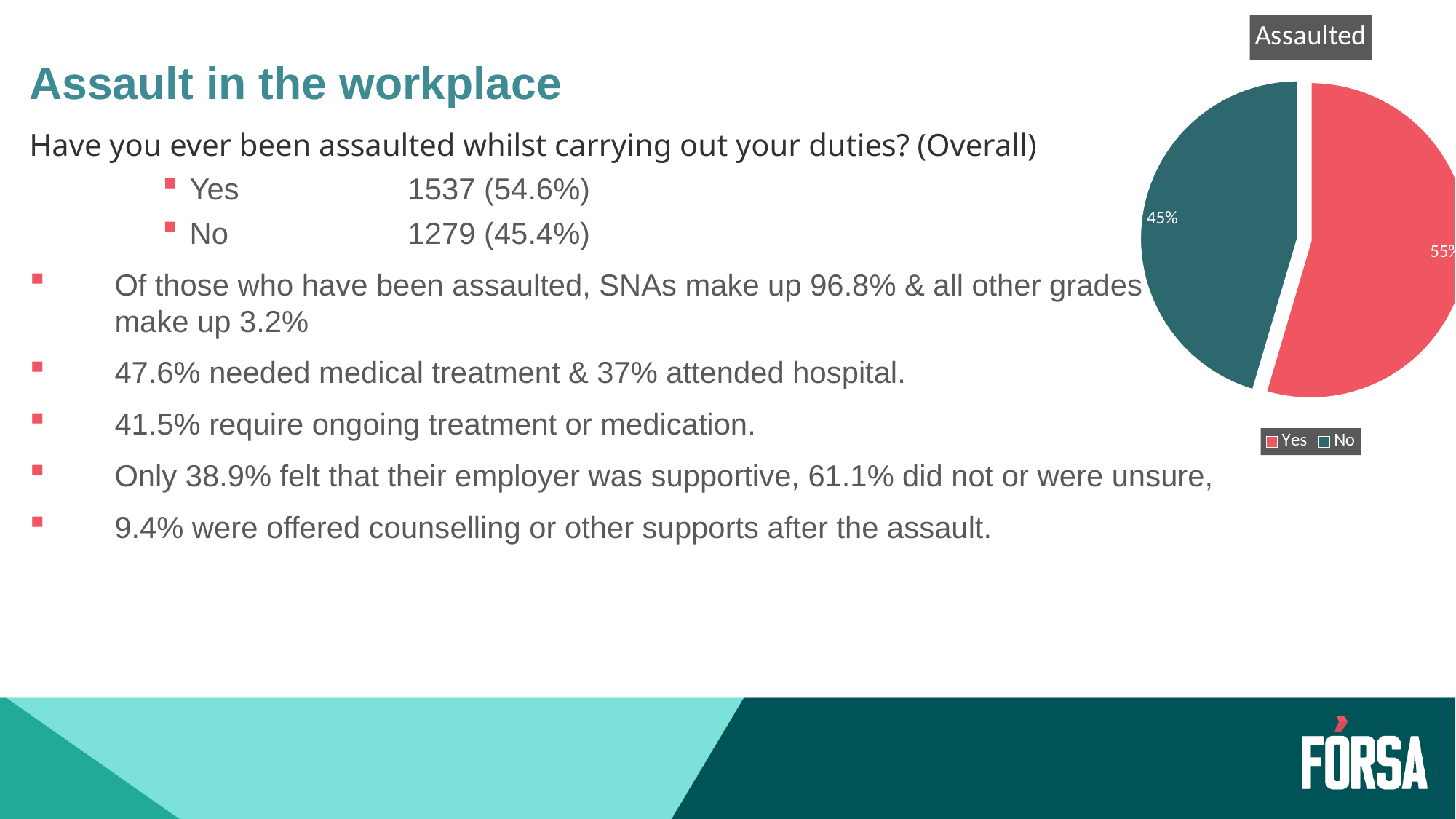
What percentage of the pie does the Yes slice represent? 55% What is the title of the chart? Assaulted What percentage of the pie does the No slice represent? 45% Which is larger in the pie chart, Yes or No? Yes How many entries does the chart legend list? 2 How many slices does the pie chart have? 2 Which slice of the pie is the largest? Yes Which slice of the pie is the smallest? No What kind of chart is shown on the slide? pie chart What is the difference in percentage points between the Yes and No slices? 10 What colour is the Yes slice in the pie chart? red Is the share for Yes greater or less than 50%? greater